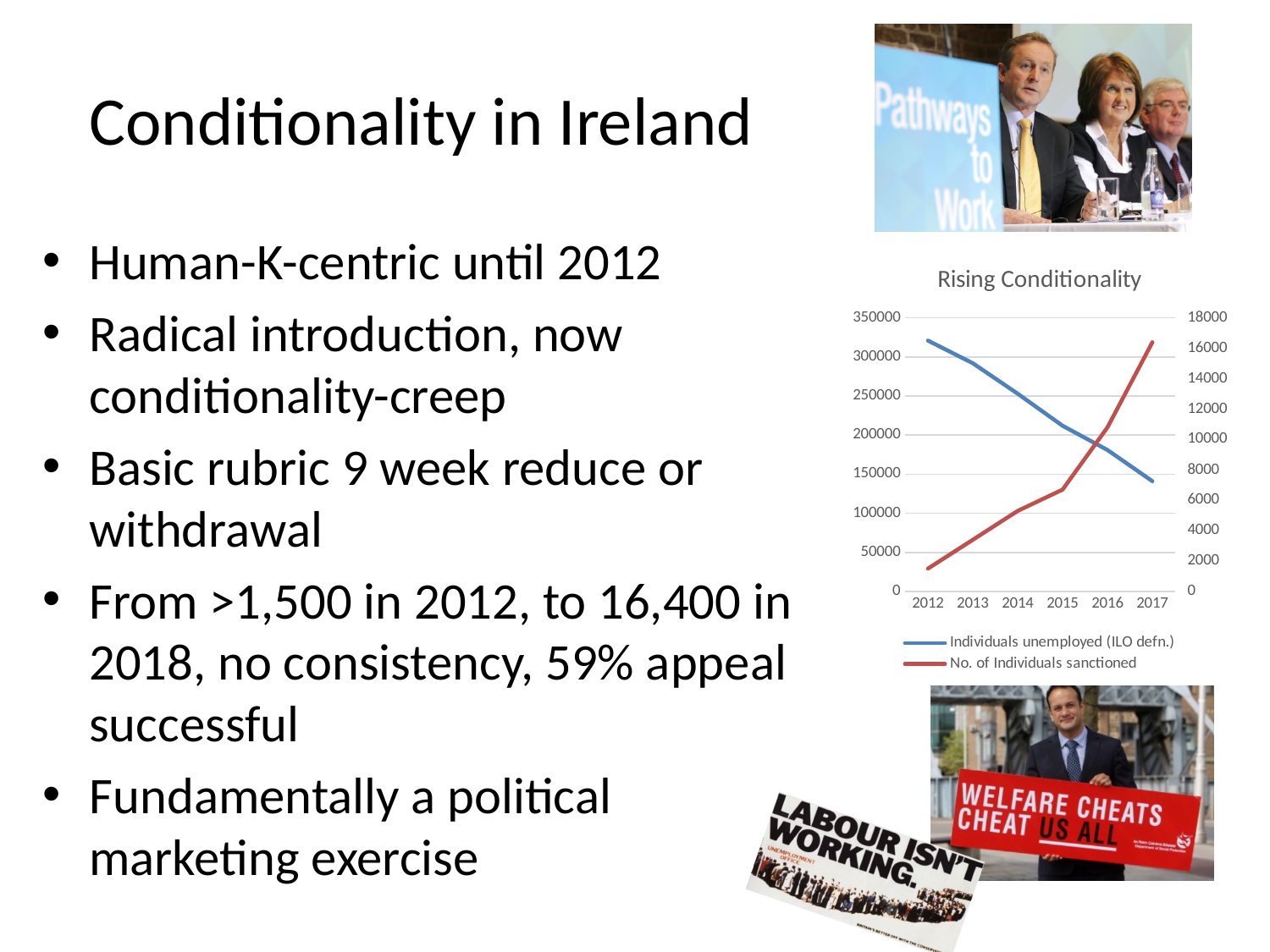
Do the values for Individuals unemployed (ILO defn.) rise or fall from 2012 to 2017? fall How many series does the chart's legend list? 2 How many years are plotted along the x axis of the chart? 6 Is the value for No. of Individuals sanctioned in 2017 greater or less than 14000? greater What kind of chart is shown on the slide? line chart Do the values for No. of Individuals sanctioned rise or fall from 2012 to 2017? rise Is the value for No. of Individuals sanctioned in 2012 greater or less than 4000? less What is the title of the chart on the slide? Rising Conditionality Is the value for Individuals unemployed (ILO defn.) in 2012 greater or less than 300000? greater In which year is the No. of Individuals sanctioned lowest? 2012 Which series is drawn in red in the chart? No. of Individuals sanctioned In which year is the number of Individuals unemployed (ILO defn.) highest? 2012